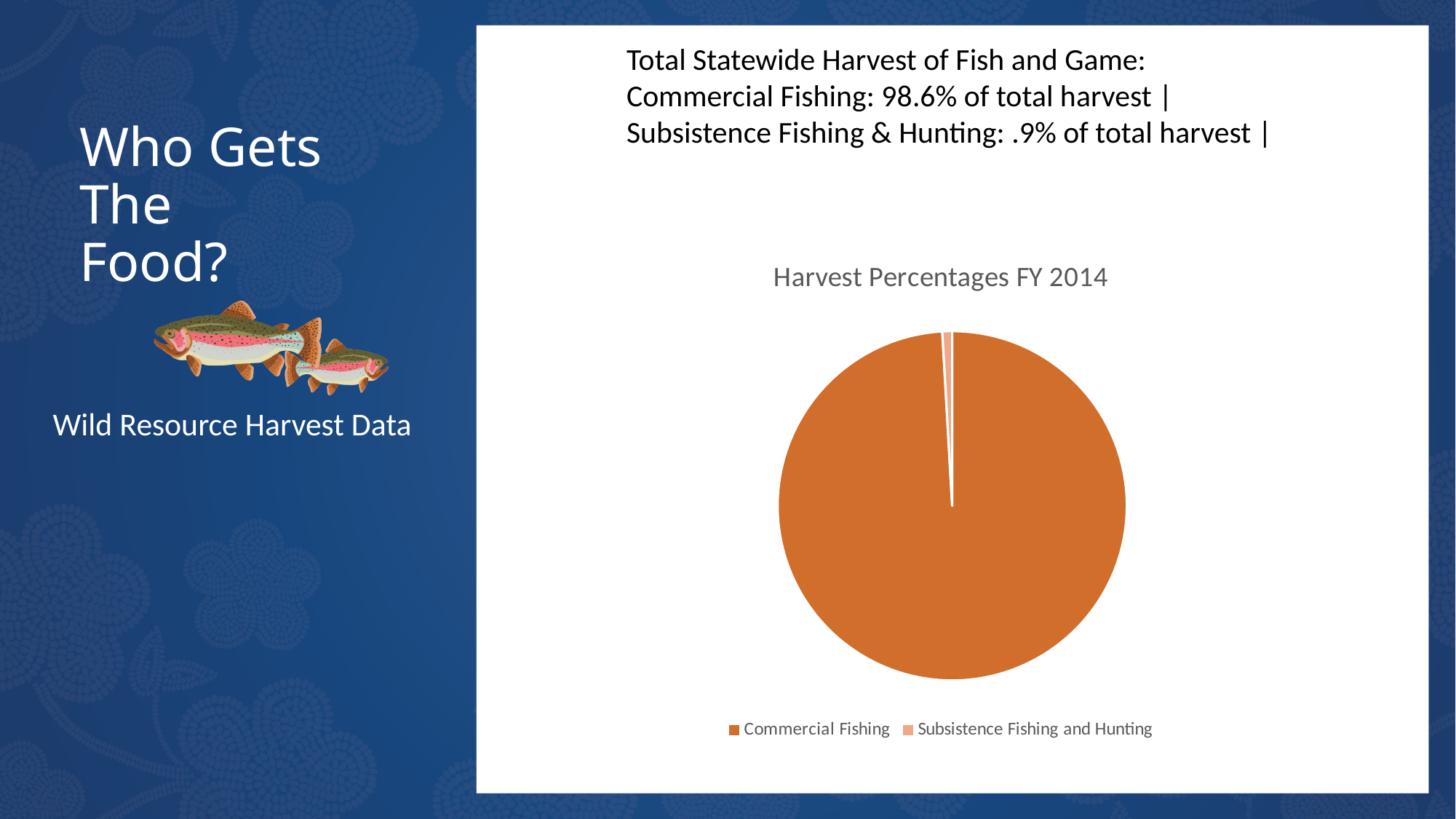
What colour is the Commercial Fishing slice in the pie chart? orange Which category takes up the smallest share of the pie chart? Subsistence Fishing and Hunting Which category takes up the largest share of the pie chart? Commercial Fishing According to the slide, what share of the total harvest is Subsistence Fishing & Hunting? .9% According to the slide, what share of the total harvest is Commercial Fishing? 98.6% How many slices does the pie chart have? 2 What is the title of the pie chart? Harvest Percentages FY 2014 How many entries does the legend of the pie chart list? 2 What kind of chart is shown on the slide? pie chart Which is larger in the pie chart, Commercial Fishing or Subsistence Fishing and Hunting? Commercial Fishing Which fiscal year does the pie chart cover? FY 2014